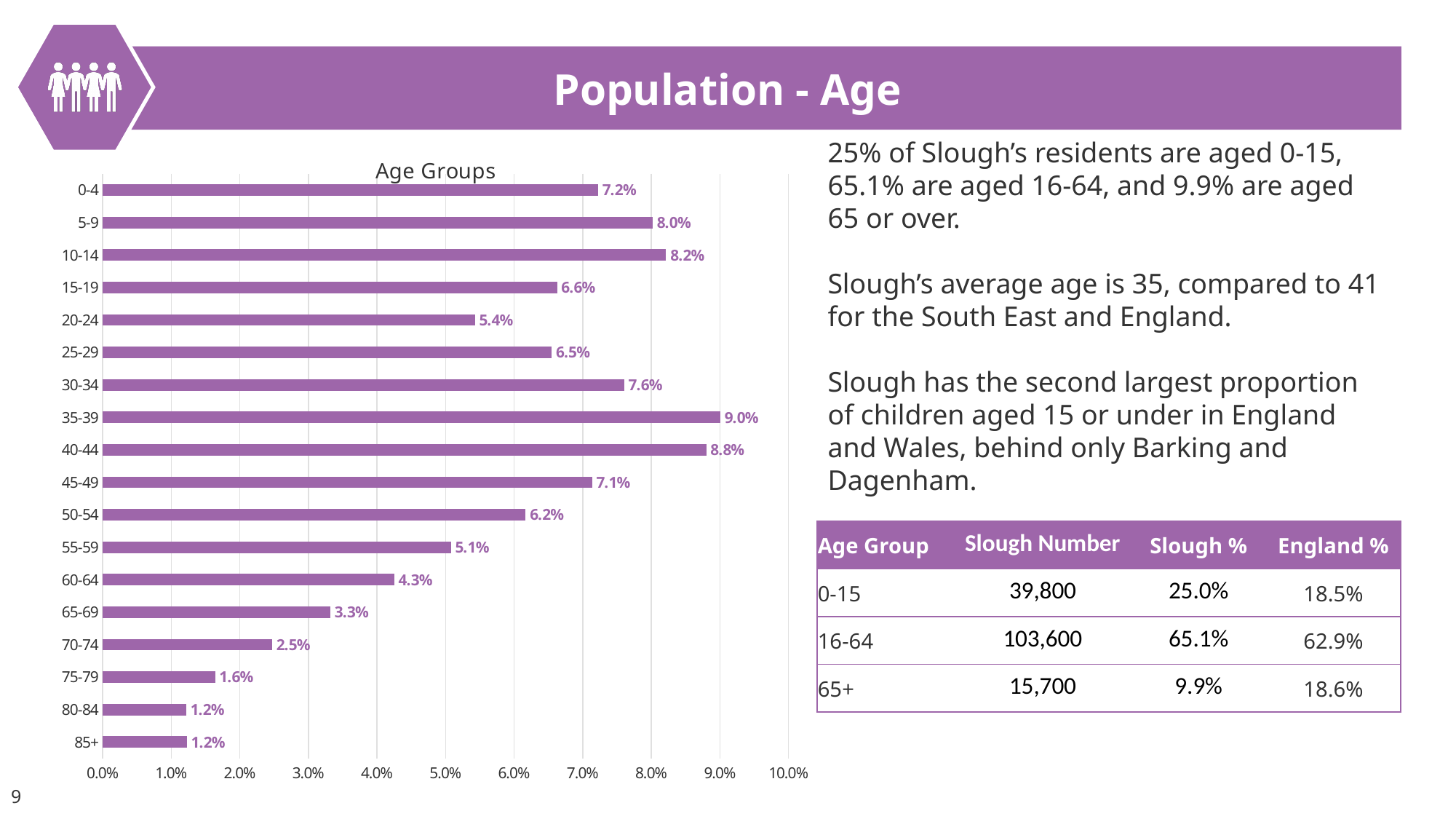
What is the value for the 60-64 age group in the Age Groups chart? 4.3% What kind of chart is the Age Groups chart? bar chart Which is larger in the Age Groups chart: the value for 20-24 or the value for 25-29? 25-29 How many age groups are shown in the Age Groups chart? 18 What is the difference between the values for the 10-14 and 15-19 age groups in the Age Groups chart? 1.6% Do the values in the Age Groups chart generally rise or fall from the 40-44 age group down to the 85+ age group? fall What is the title of the chart on the slide? Age Groups What is the value for the 0-4 age group in the Age Groups chart? 7.2% Which age group has the highest value in the Age Groups chart? 35-39 What is the value for the 35-39 age group in the Age Groups chart? 9.0% Is the value for the 40-44 age group greater or less than 8.0% in the Age Groups chart? greater